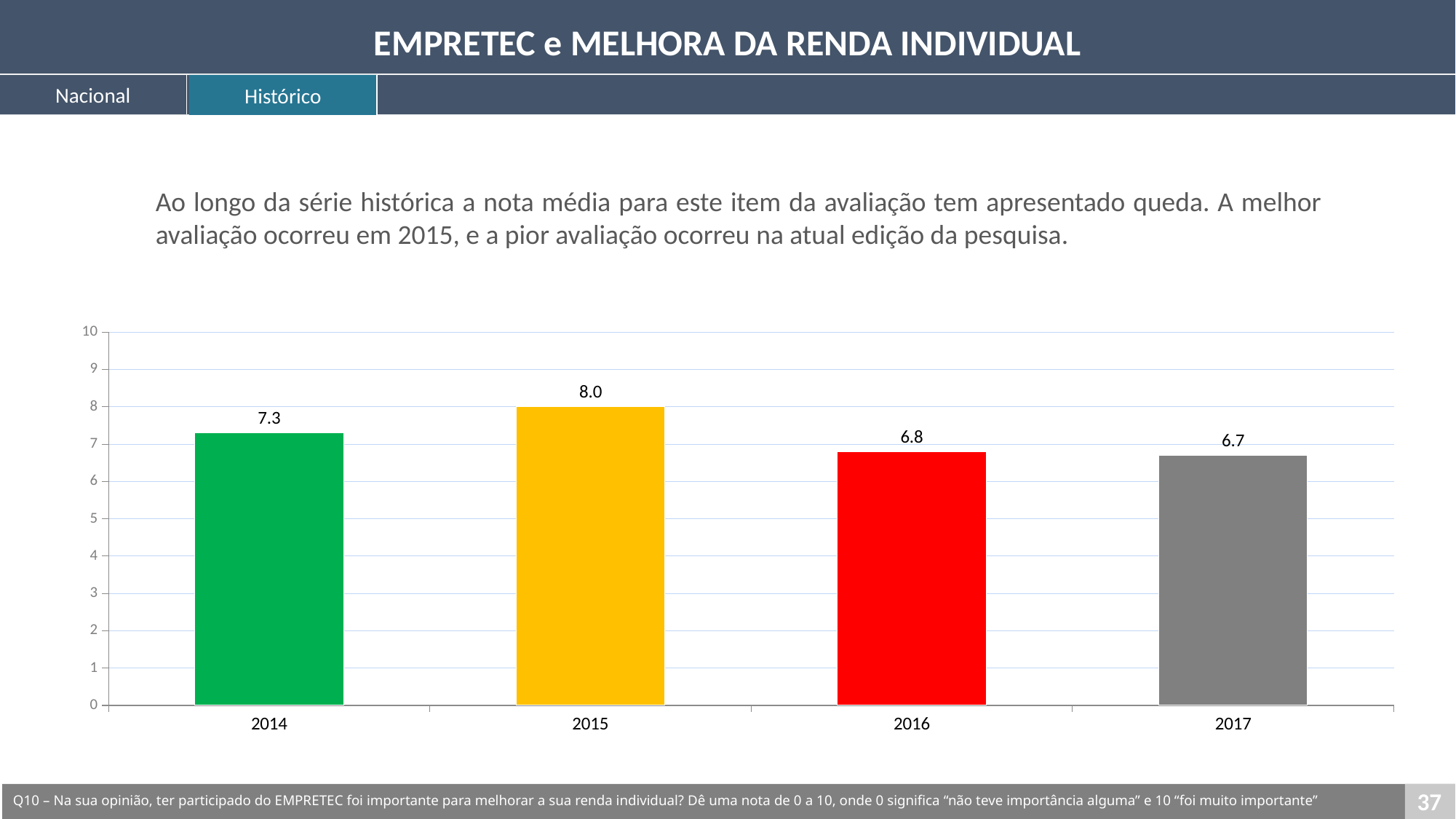
What is the value for 2017? 6.7 Which is larger, the value for 2014 or the value for 2016? 2014 Is the value for 2015 greater or less than 7? greater How many years are shown on the x axis? 4 What is the difference between the values for 2015 and 2017? 1.3 Which year has the lowest value? 2017 What is the value for 2015? 8.0 What is the value for 2016? 6.8 What is the value for 2014? 7.3 What kind of chart is shown on the slide? bar chart Which year has the highest value? 2015 What colour is the bar for 2015? yellow